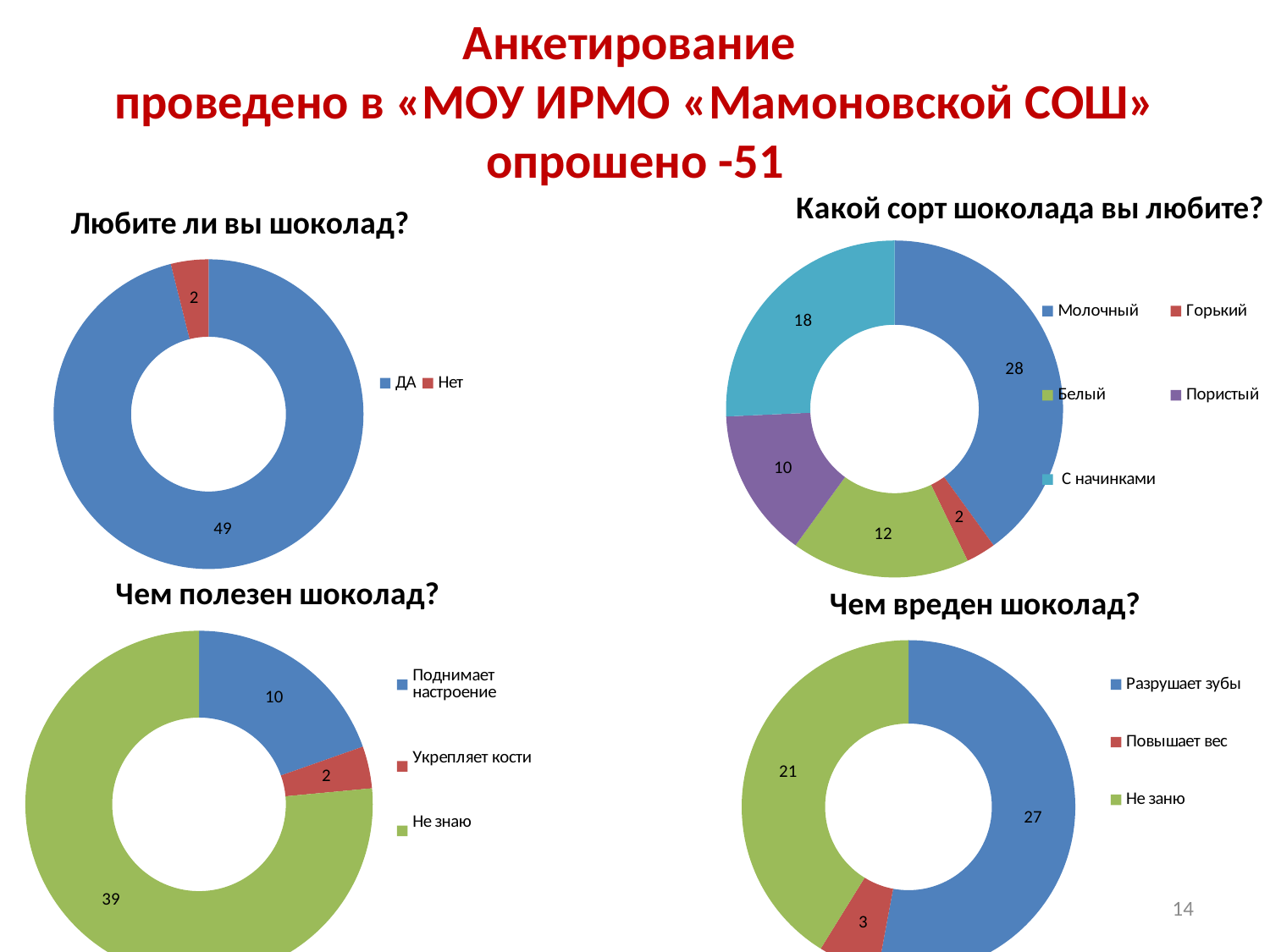
In the chart 'Любите ли вы шоколад?', what is the value for 'ДА'? 49 In the chart 'Какой сорт шоколада вы любите?', what share of the total does 'Молочный' represent? 40% In the chart 'Какой сорт шоколада вы любите?', how many categories does the legend list? 5 In the chart 'Какой сорт шоколада вы любите?', what is the value for 'С начинками'? 18 In the chart 'Чем вреден шоколад?', what is the difference between 'Разрушает зубы' and 'Не заню'? 6 In the chart 'Какой сорт шоколада вы любите?', which category has the lowest value? Горький In the chart 'Чем полезен шоколад?', which is larger: 'Поднимает настроение' or 'Укрепляет кости'? Поднимает настроение In the chart 'Чем полезен шоколад?', what is the value for 'Не знаю'? 39 In the chart 'Какой сорт шоколада вы любите?', which category has the highest value? Молочный What type of chart is 'Чем вреден шоколад?'? Doughnut chart In the chart 'Какой сорт шоколада вы любите?', what is the difference between 'Молочный' and 'Белый'? 16 In the chart 'Любите ли вы шоколад?', what is the value for 'Нет'? 2